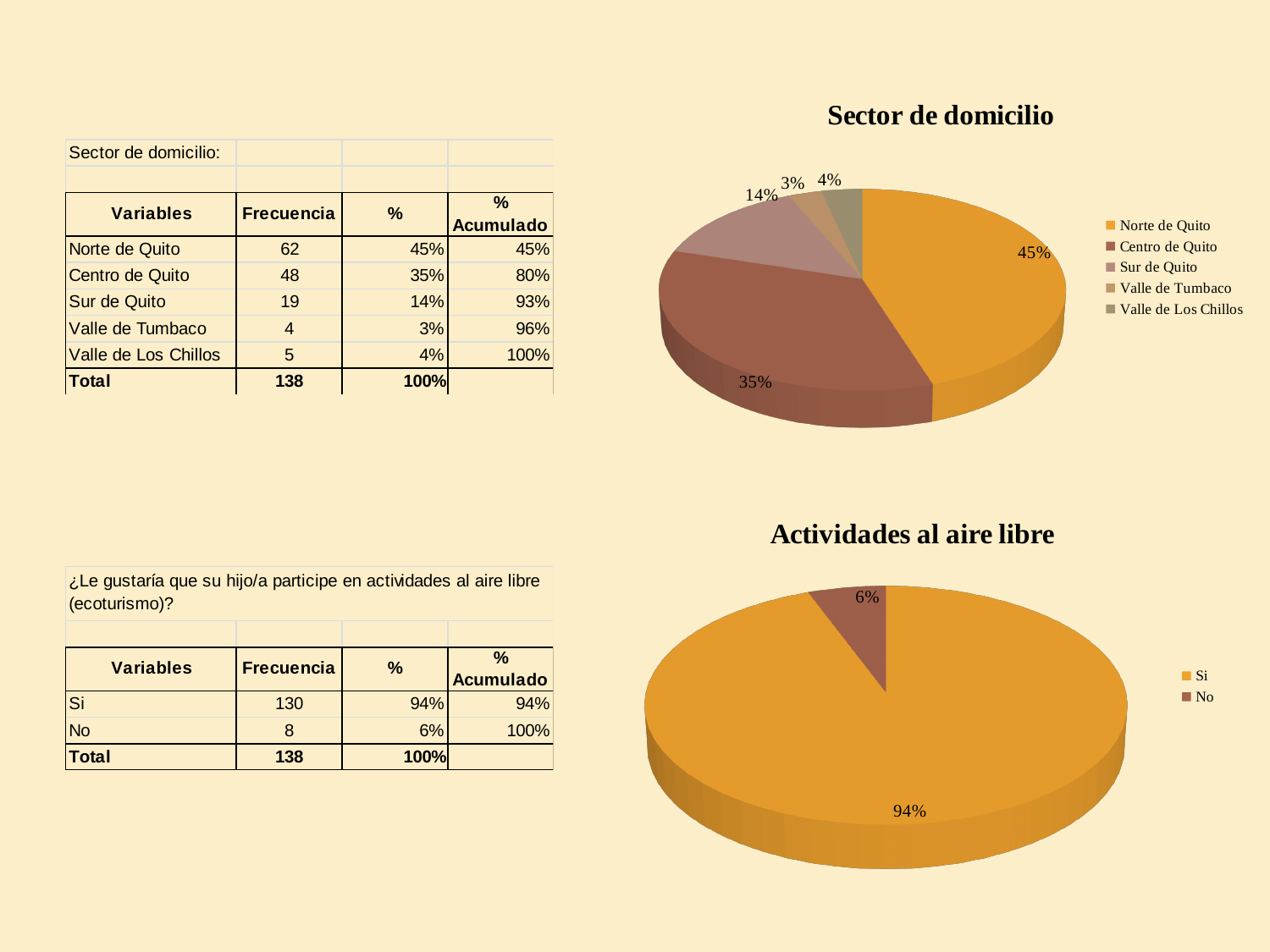
What kind of chart is 'Actividades al aire libre'? Pie chart In the 'Sector de domicilio' chart, which is larger, Sur de Quito or Valle de Los Chillos? Sur de Quito In the 'Sector de domicilio' chart, what is the difference in percentage points between Norte de Quito and Centro de Quito? 10% In the 'Sector de domicilio' chart, what share of the pie does Norte de Quito have? 45% In the 'Sector de domicilio' chart, which category has the smallest slice? Valle de Tumbaco In the 'Actividades al aire libre' chart, what share of the pie does 'No' have? 6% In the 'Sector de domicilio' chart, which category has the largest slice? Norte de Quito In the 'Actividades al aire libre' chart, how many categories does the legend list? 2 In the 'Sector de domicilio' chart, what share of the pie does Centro de Quito have? 35% In the 'Sector de domicilio' chart, how many categories does the legend list? 5